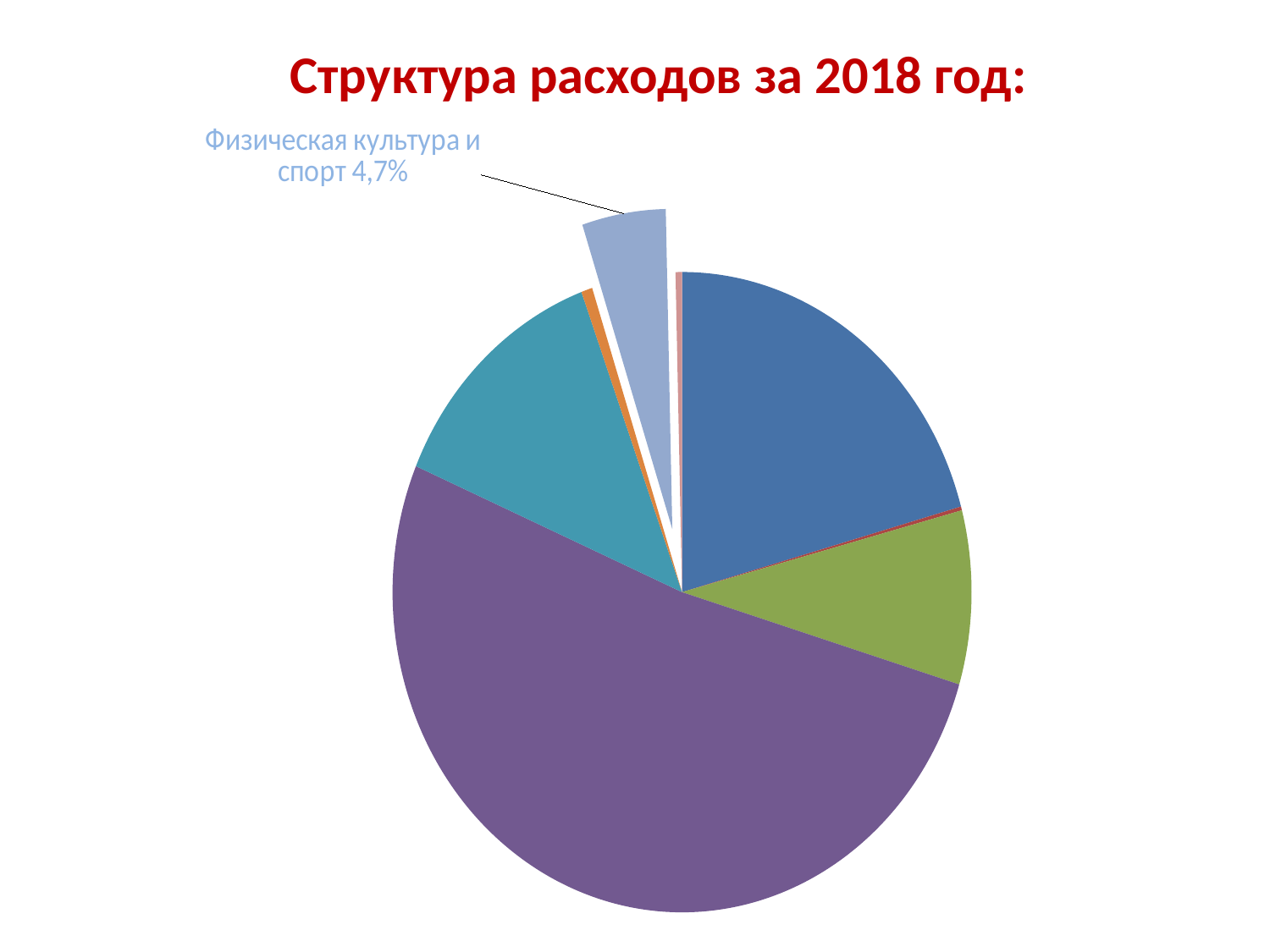
Which slice of the pie is labelled with a value on the chart? Физическая культура и спорт Which slice is pulled out (exploded) from the pie? Физическая культура и спорт Is the Физическая культура и спорт slice the largest slice of the pie? No What kind of chart is shown on the slide? Pie chart Which colour slice is the largest in the pie? Purple What is the title of the chart? Структура расходов за 2018 год: What share of expenses does Физическая культура и спорт account for? 4,7% Which is larger, the dark blue slice or the Физическая культура и спорт slice? The dark blue slice Which is larger, the purple slice or the green slice? The purple slice Does the chart show a legend? No